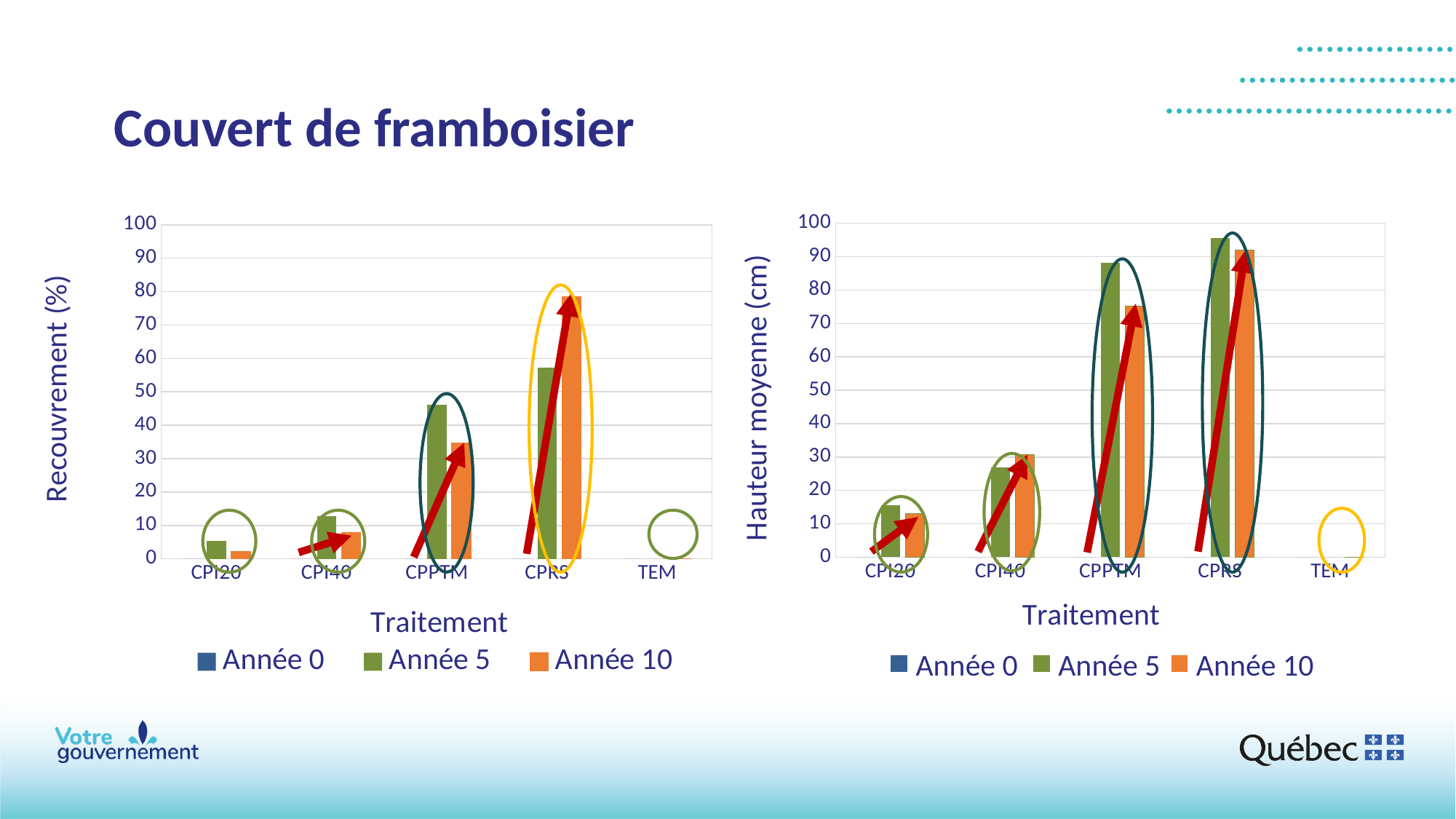
In the right chart (Hauteur moyenne (cm)), is the Année 10 value for CPI40 greater or less than 20? greater In the right chart (Hauteur moyenne (cm)), which is larger: the Année 5 value for CPRS or the Année 5 value for CPPTM? CPRS In the left chart (Recouvrement (%)), is the Année 10 value for CPRS greater or less than 70? greater In the left chart (Recouvrement (%)), which treatment has the highest Année 10 value? CPRS In the right chart (Hauteur moyenne (cm)), is the Année 5 value for CPPTM greater or less than 80? greater In the left chart (Recouvrement (%)), for CPPTM, which is larger: the Année 5 value or the Année 10 value? Année 5 In the left chart (Recouvrement (%)), how many treatment categories are shown on the x axis? 5 What is the y-axis title of the right chart? Hauteur moyenne (cm) In the left chart (Recouvrement (%)), how many series does the legend list? 3 What kind of chart is the left chart (Recouvrement (%))? bar chart In the right chart (Hauteur moyenne (cm)), which treatment has the highest Année 5 value? CPRS